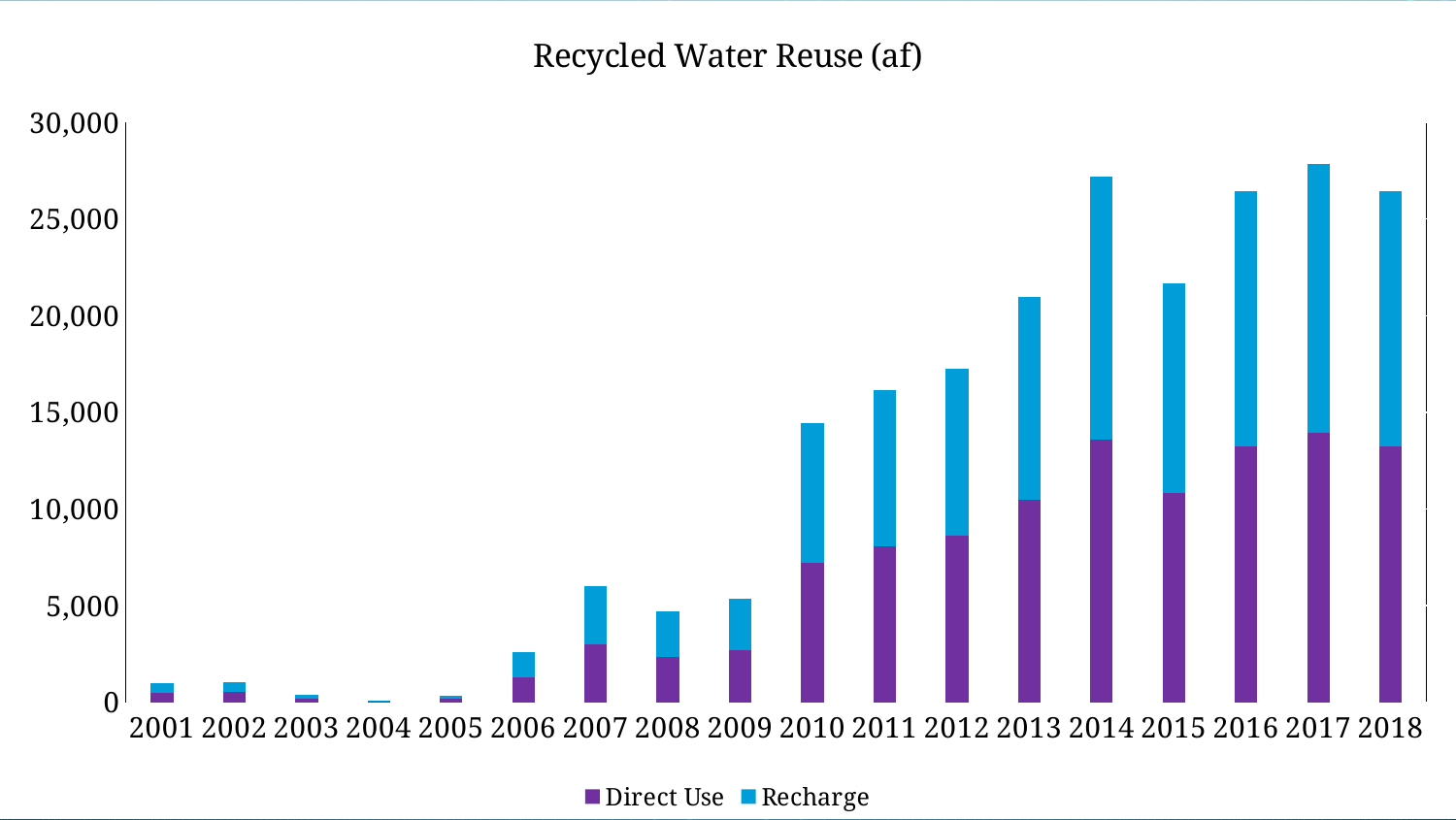
Overall, do the total values rise or fall from 2001 to 2018? rise Is the total recycled water reuse for 2010 greater or less than 15,000? less How many series does the legend list? 2 What is the title of the chart? Recycled Water Reuse (af) Which year has the larger total recycled water reuse, 2007 or 2008? 2007 Is the total recycled water reuse for 2014 greater or less than 25,000? greater Is the total recycled water reuse for 2012 greater or less than 15,000? greater What kind of chart is shown on the slide? Stacked bar chart Which year has the lowest total recycled water reuse? 2004 How many years are shown on the x axis? 18 Which year has the larger total recycled water reuse, 2015 or 2016? 2016